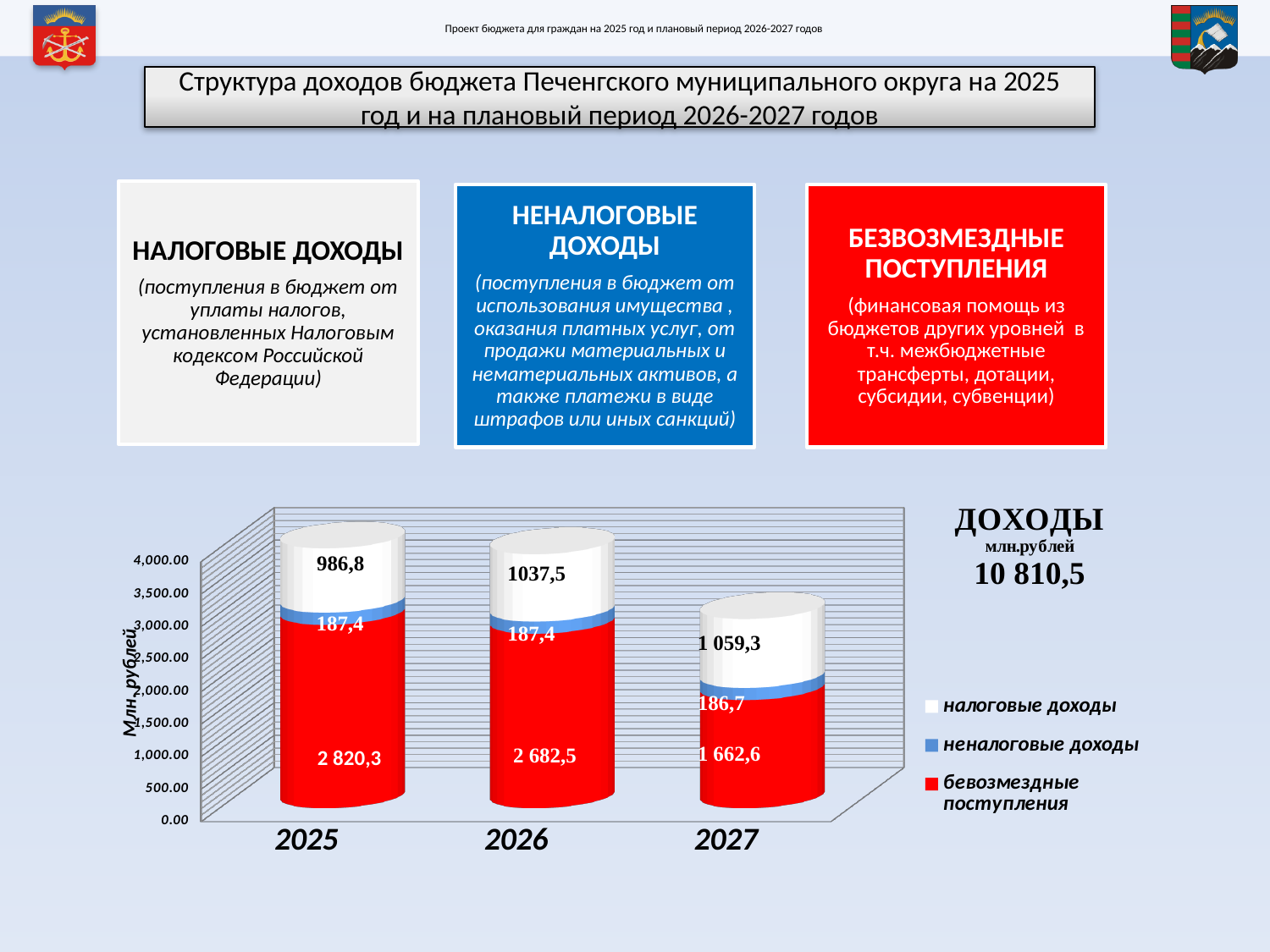
In which year is the value of налоговые доходы the highest? 2027 What is the value of безвозмездные поступления for 2025? 2 820,3 What type of chart is shown on the slide? stacked bar chart Does the value of безвозмездные поступления rise or fall from 2025 to 2027? fall In which year is the value of безвозмездные поступления the lowest? 2027 What is the difference between безвозмездные поступления in 2025 and in 2027? 1 157,7 How many series does the chart legend list? 3 What is the total of the stacked bar for 2027? 2 908,6 Which is larger: налоговые доходы in 2025 or in 2026? 2026 How many years (categories) are shown on the x axis of the chart? 3 What is the value of налоговые доходы for 2026? 1037,5 What is the value of неналоговые доходы for 2027? 186,7